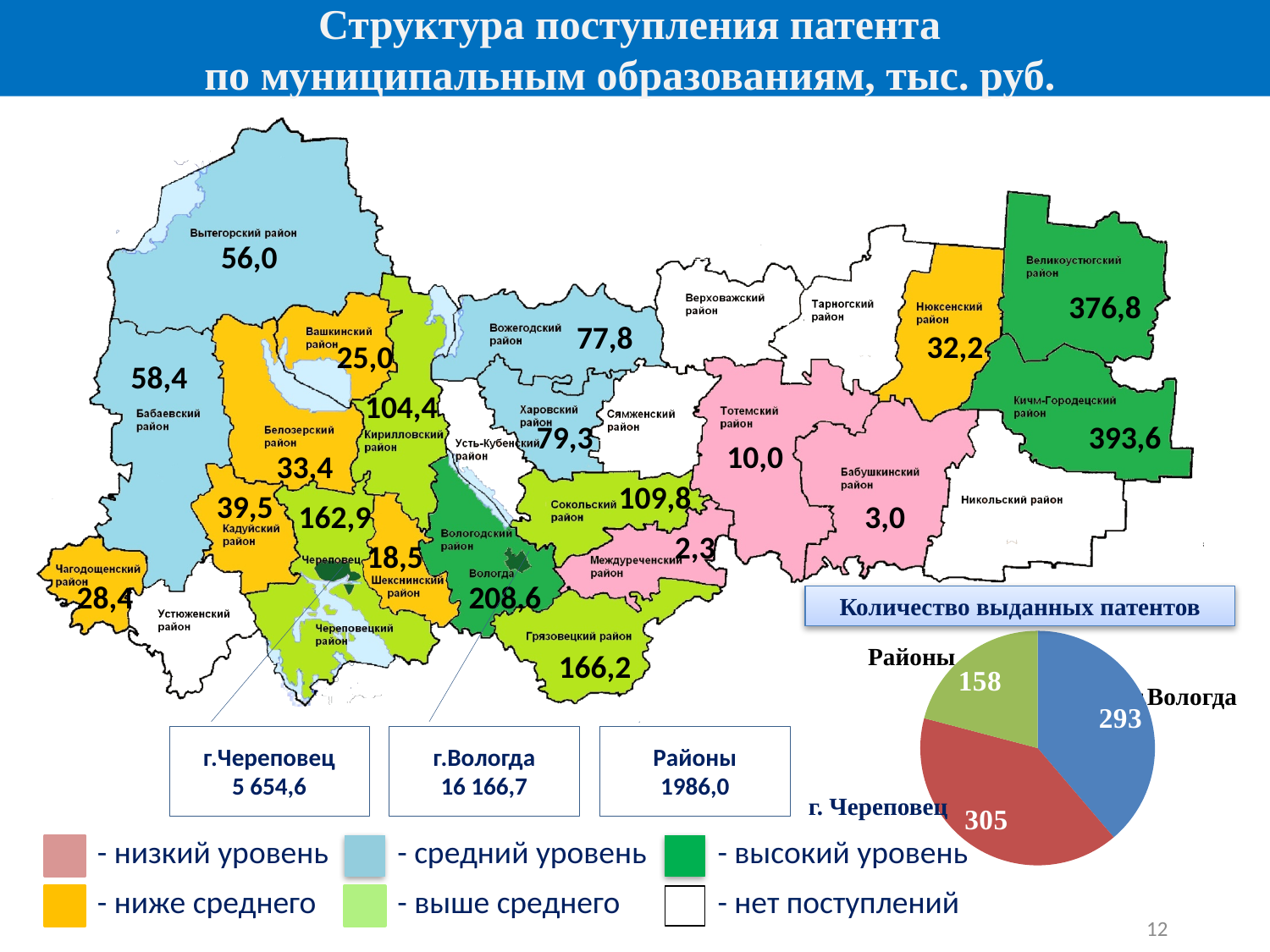
In the 'Количество выданных патентов' pie chart, what is the value for Районы? 158 In the 'Количество выданных патентов' pie chart, which category has the largest value? г. Череповец In the 'Количество выданных патентов' pie chart, what share of the total does Районы represent? 20.9% What is the title of the pie chart on the slide? Количество выданных патентов What kind of chart is the 'Количество выданных патентов' chart? pie chart In the 'Количество выданных патентов' pie chart, what is the total of all three slices? 756 In the 'Количество выданных патентов' pie chart, what is the value for г. Череповец? 305 In the 'Количество выданных патентов' pie chart, what is the difference between г. Череповец and Вологда? 12 In the 'Количество выданных патентов' pie chart, which is larger: Вологда or Районы? Вологда In the 'Количество выданных патентов' pie chart, which category has the smallest value? Районы In the 'Количество выданных патентов' pie chart, what is the value for Вологда? 293 How many slices does the 'Количество выданных патентов' pie chart have? 3